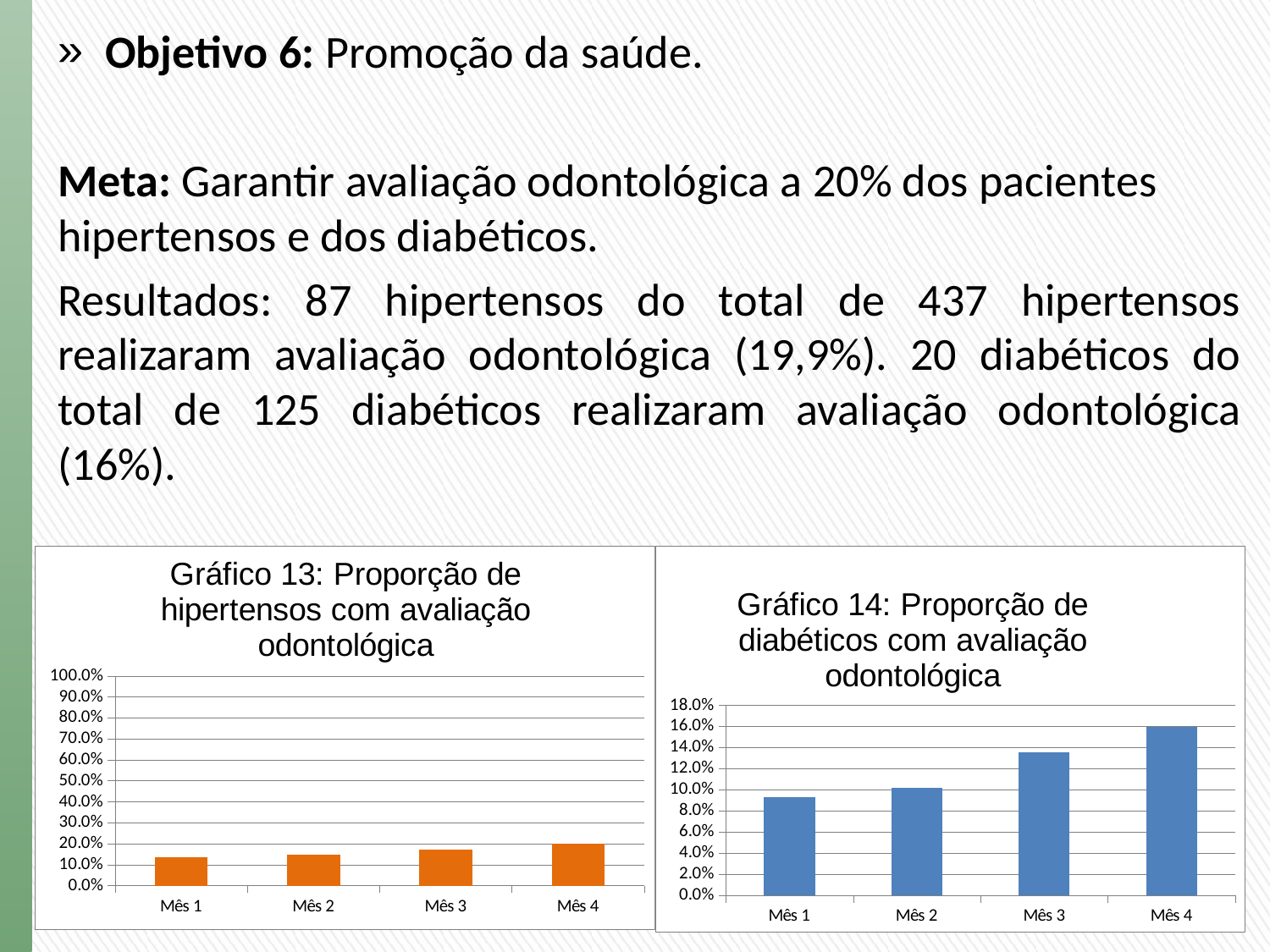
In Gráfico 14, which is larger, the value for Mês 2 or the value for Mês 3? Mês 3 In Gráfico 14, which month has the lowest proportion? Mês 1 In Gráfico 14, is the value for Mês 3 greater or less than 12.0%? greater In Gráfico 13, which month has the highest proportion of hipertensos com avaliação odontológica? Mês 4 How many categories are shown on the x axis of Gráfico 14? 4 In Gráfico 13, is the value for Mês 1 greater or less than 10.0%? greater In Gráfico 13, is the value for Mês 4 greater or less than 30.0%? less In Gráfico 13, do the values rise or fall from Mês 1 to Mês 4? rise What type of chart is Gráfico 13? bar chart In Gráfico 14, which month has the highest proportion of diabéticos com avaliação odontológica? Mês 4 In Gráfico 13, which month has the lowest proportion? Mês 1